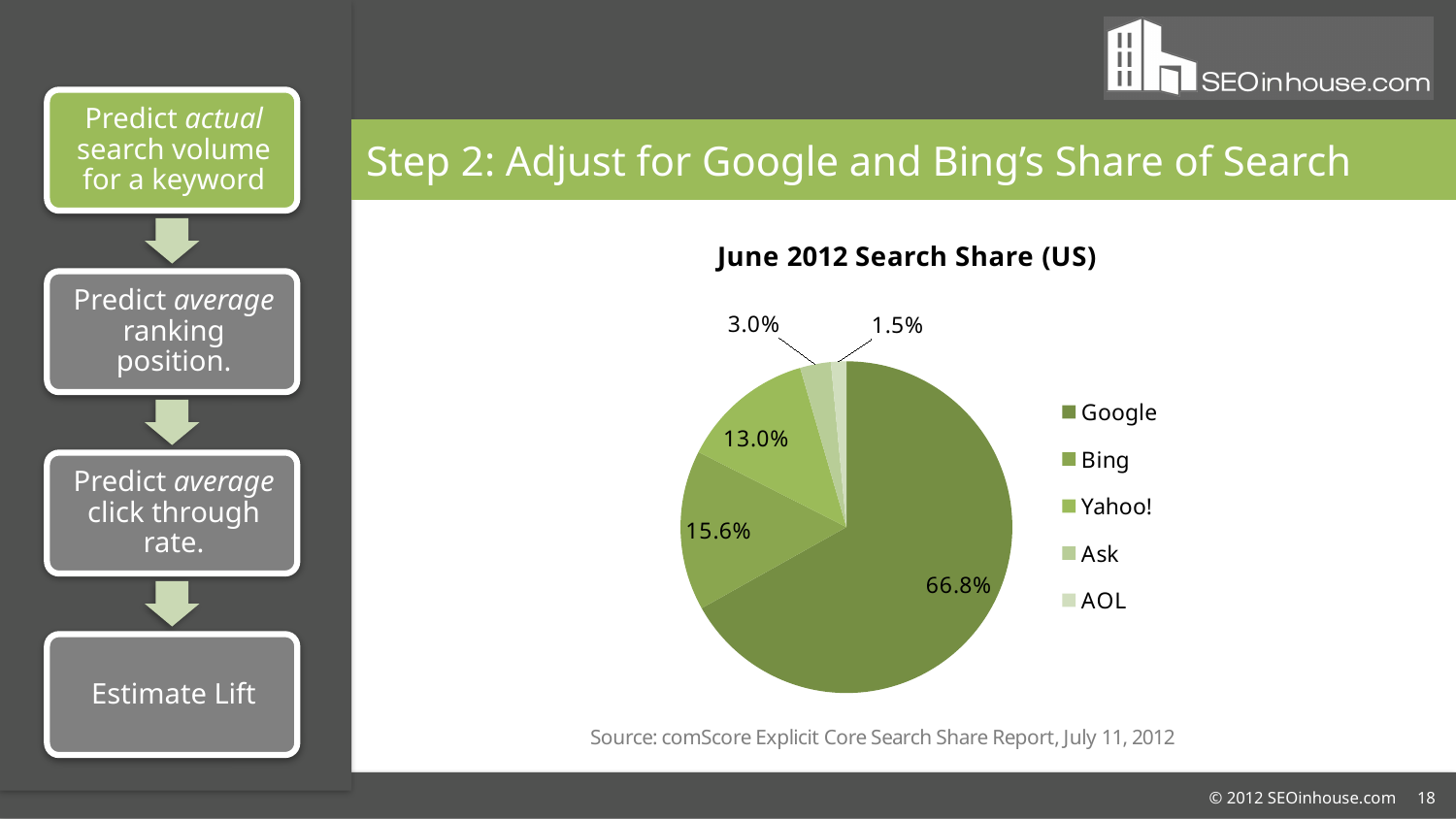
Which search engine has the smallest slice of the pie chart? AOL What share of search does Google have in the pie chart? 66.8% What share of search does Ask have in the pie chart? 3.0% What share of search does Bing have in the pie chart? 15.6% Which search engine has the largest slice of the pie chart? Google What is the difference between Google's and Bing's share of search? 51.2% How many search engines are shown in the pie chart? 5 What is the title of the chart? June 2012 Search Share (US) Which has a larger share of search, Bing or Yahoo!? Bing What share of search does Yahoo! have in the pie chart? 13.0% What share of search does AOL have in the pie chart? 1.5% What kind of chart is shown on the slide? Pie chart